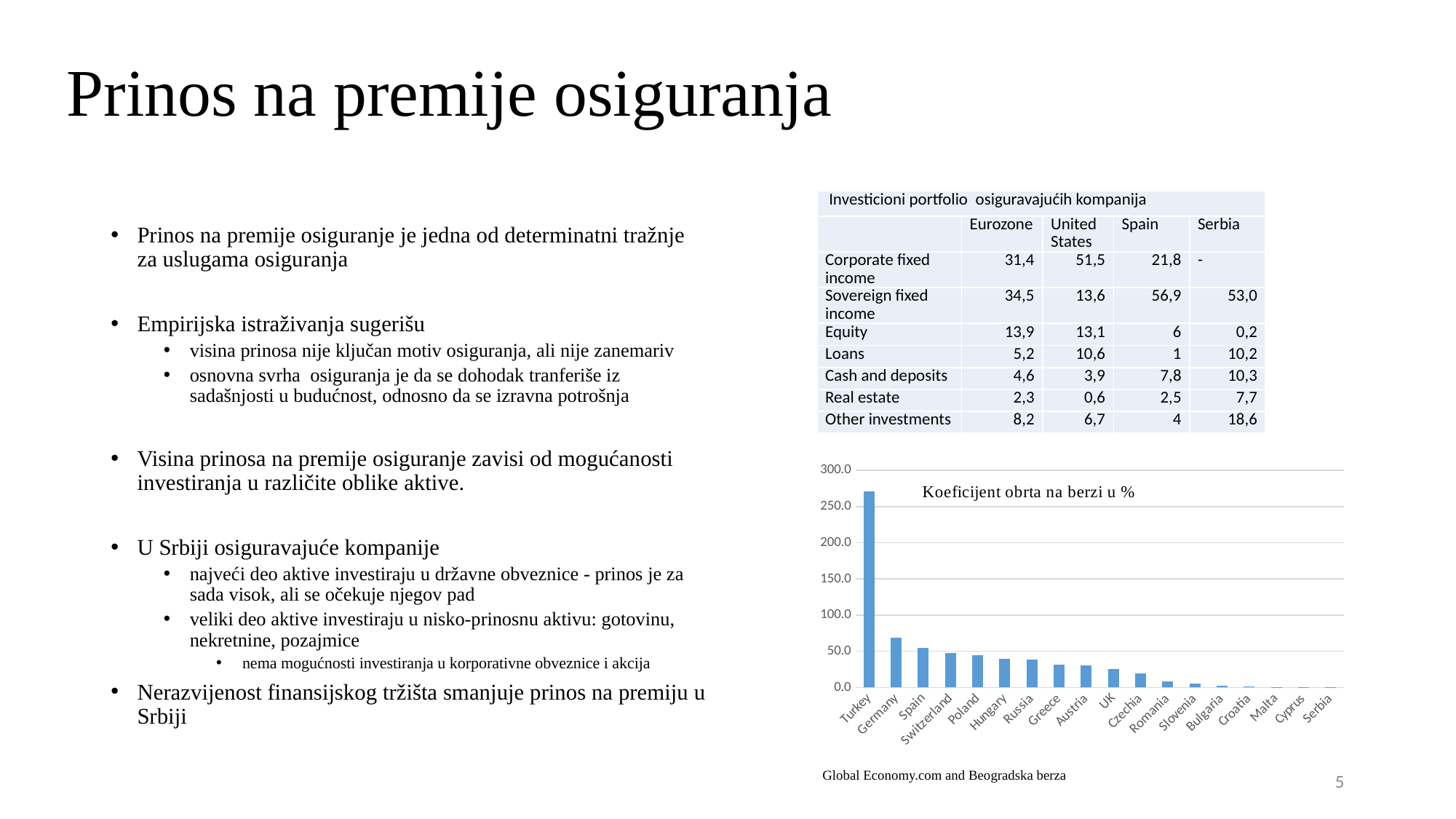
Which has a larger value, Germany or Spain? Germany Which has a larger value, Poland or Greece? Poland Do the values rise or fall moving from left to right along the x axis? fall What is the title of the chart on the slide? Koeficijent obrta na berzi u % How many countries are shown on the x axis of the chart? 18 What colour are the bars in the chart? blue Is the value for UK greater or less than 50? less Which country has the highest value in the chart? Turkey What kind of chart is shown on the slide? bar chart Is the value for Germany greater or less than 100? less Is the value for Turkey greater or less than 200? greater